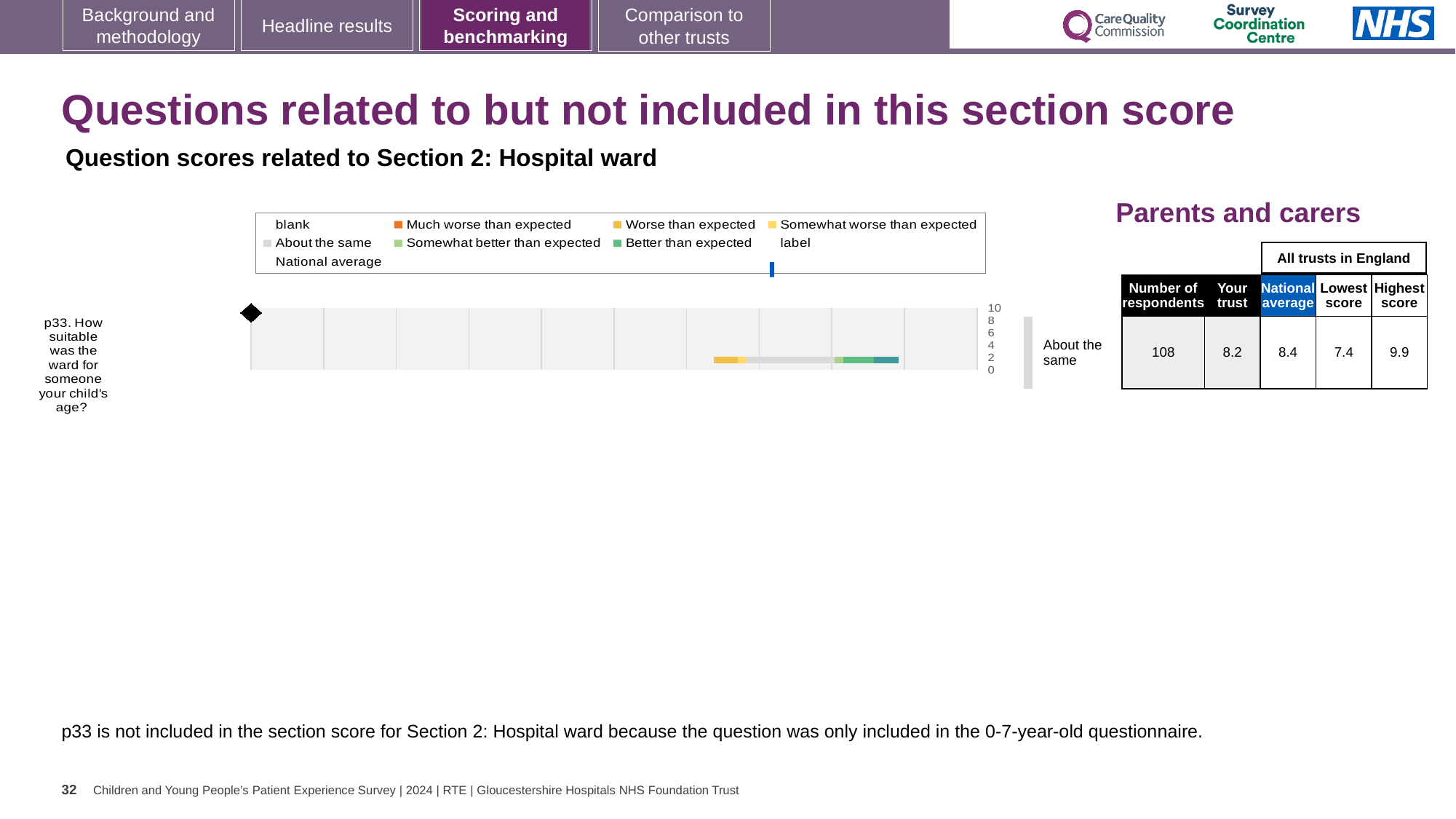
What benchmark category label is shown to the right of the bar for p33? About the same How many questions are plotted in the chart? 1 What kind of chart is used to show the p33 question score? bar chart How many respondents are listed for p33 in the table beside the chart? 108 What is the national average score for p33 in the table beside the chart? 8.4 What is the 'Your trust' score for p33 in the table beside the chart? 8.2 What is the difference between the highest score and the lowest score for p33? 2.5 Is the 'Your trust' score for p33 greater or less than 6 on the chart's axis? greater Which question is plotted in the chart? p33. How suitable was the ward for someone your child's age? Which is larger for p33, the 'Your trust' score or the national average? National average What is the lowest score among all trusts in England for p33? 7.4 What is the highest score among all trusts in England for p33? 9.9